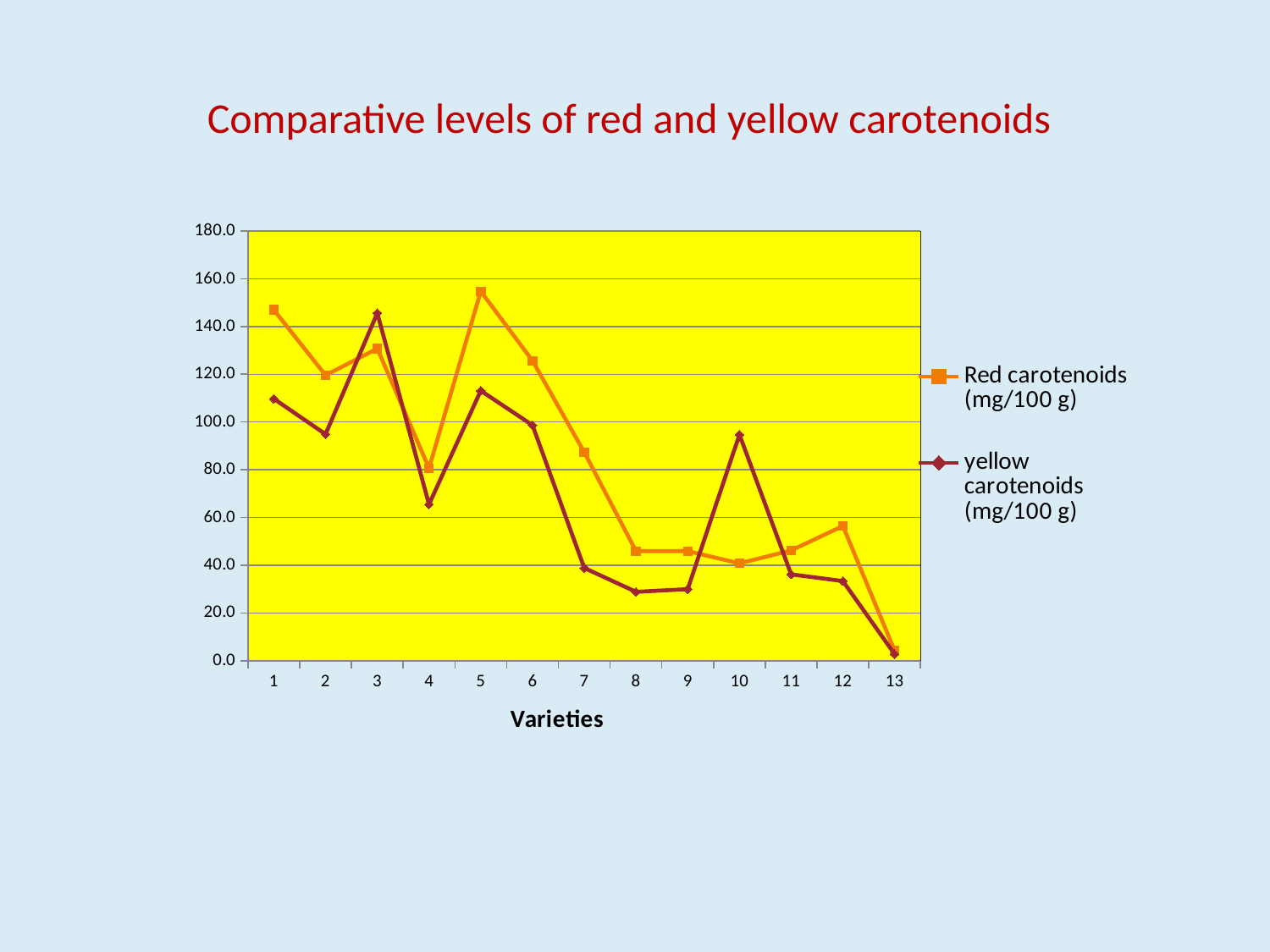
How many varieties are plotted along the x axis? 13 At variety 1, which series has the larger value, Red carotenoids or yellow carotenoids? Red carotenoids Which variety has the lowest value for Red carotenoids (mg/100 g)? 13 What kind of chart is shown on the slide? line chart Which variety has the highest value for yellow carotenoids (mg/100 g)? 3 Is the value for Red carotenoids at variety 8 greater or less than 60? less How many series does the legend list? 2 At variety 10, which series has the larger value, Red carotenoids or yellow carotenoids? yellow carotenoids Is the value for yellow carotenoids at variety 4 greater or less than 80? less Is the value for Red carotenoids at variety 1 greater or less than 140? greater Overall, do the Red carotenoids values rise or fall from variety 1 to variety 13? fall Which variety has the highest value for Red carotenoids (mg/100 g)? 5